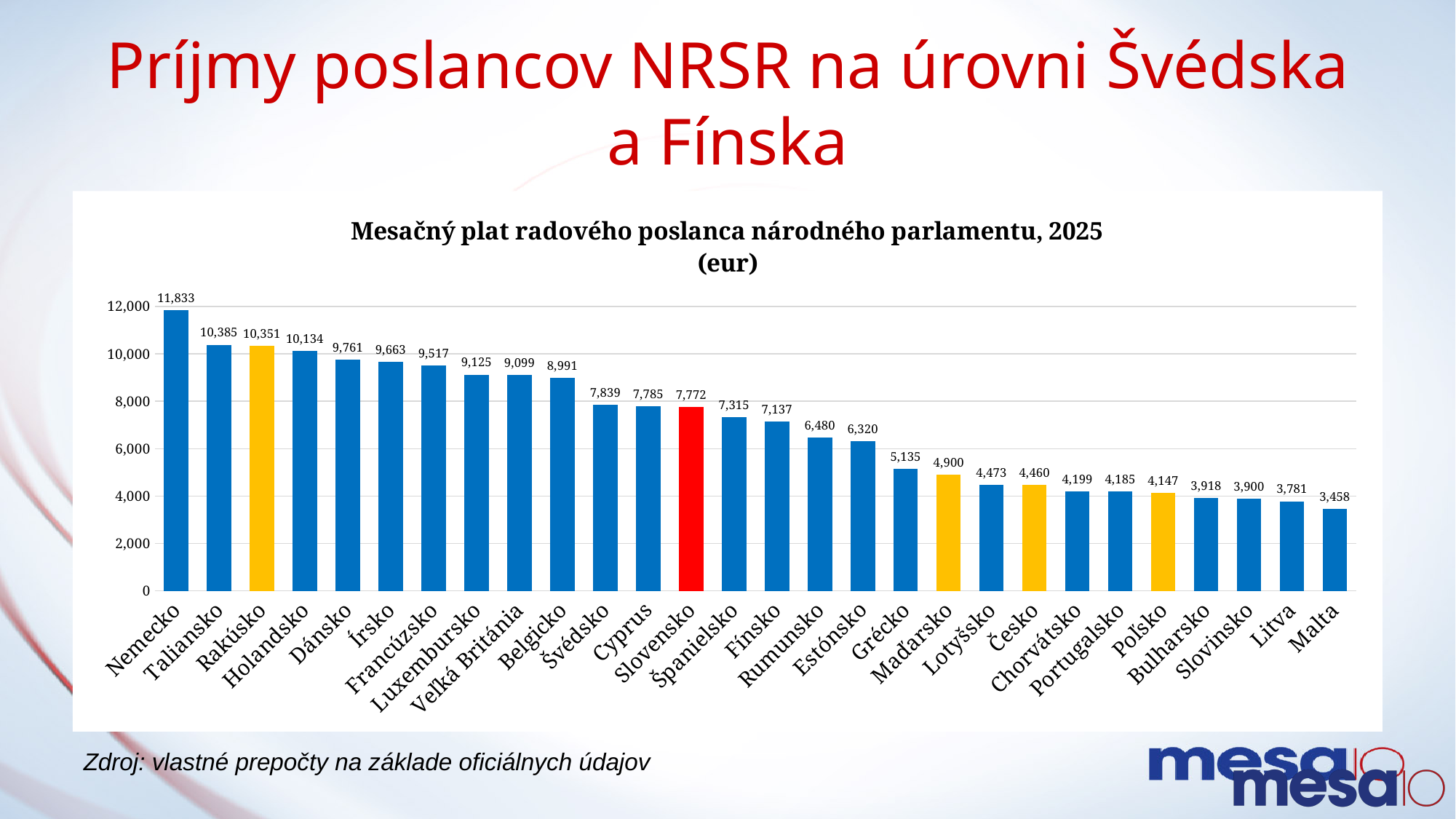
How many countries are shown in the chart? 28 Which has a larger value, Rakúsko or Holandsko? Rakúsko Which country has the highest value in the chart? Nemecko What kind of chart is shown on the slide? bar chart Is the value for Grécko greater or less than 6,000? less What is the value shown for Fínsko? 7,137 What is the monthly salary shown for Slovensko? 7,772 What is the difference between the values for Nemecko and Malta? 8,375 Which country has the lowest value in the chart? Malta What is the value shown for Česko? 4,460 Which country's bar is coloured red in the chart? Slovensko What is the difference between the values for Slovensko and Česko? 3,312